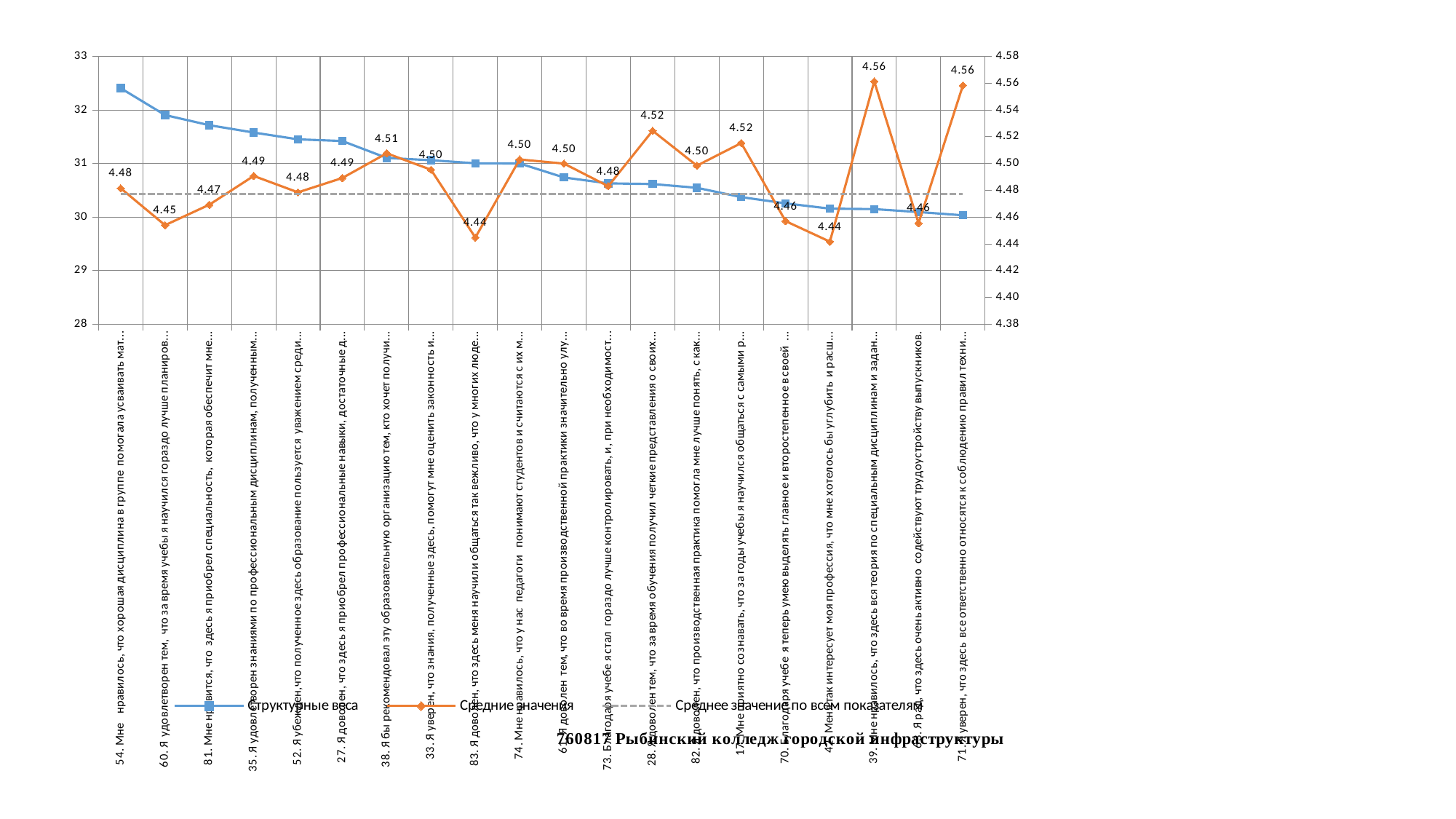
How many entries does the chart legend list? 3 What is the lowest value shown on the 'Средние значения' line? 4.44 What is the 'Средние значения' value for item 38 ('Я бы рекомендовал эту образовательную организацию тем, кто хочет получи…')? 4.51 What is the difference between the 'Средние значения' value for item 39 (4.56) and item 60 (4.45)? 0.11 What is the 'Средние значения' value for item 60 ('Я удовлетворен тем, что за время учебы я научился гораздо лучше планиров…')? 4.45 How many categories (survey items) are plotted along the x axis? 20 Is the 'Структурные веса' value for the first category (item 54) greater or less than 32 on the left axis? greater What is the 'Средние значения' value for item 54 ('Мне нравилось, что хорошая дисциплина в группе помогала усваивать мат…')? 4.48 What is the highest value shown on the 'Средние значения' line? 4.56 Does the 'Структурные веса' line rise or fall from left to right along the x axis? fall What kind of chart is shown on the slide? line chart Which has the larger 'Средние значения' value: item 28 ('Я доволен тем, что за время обучения получил четкие представления…') or item 83 ('Я доволен, что здесь меня научили общаться так вежливо…')? item 28